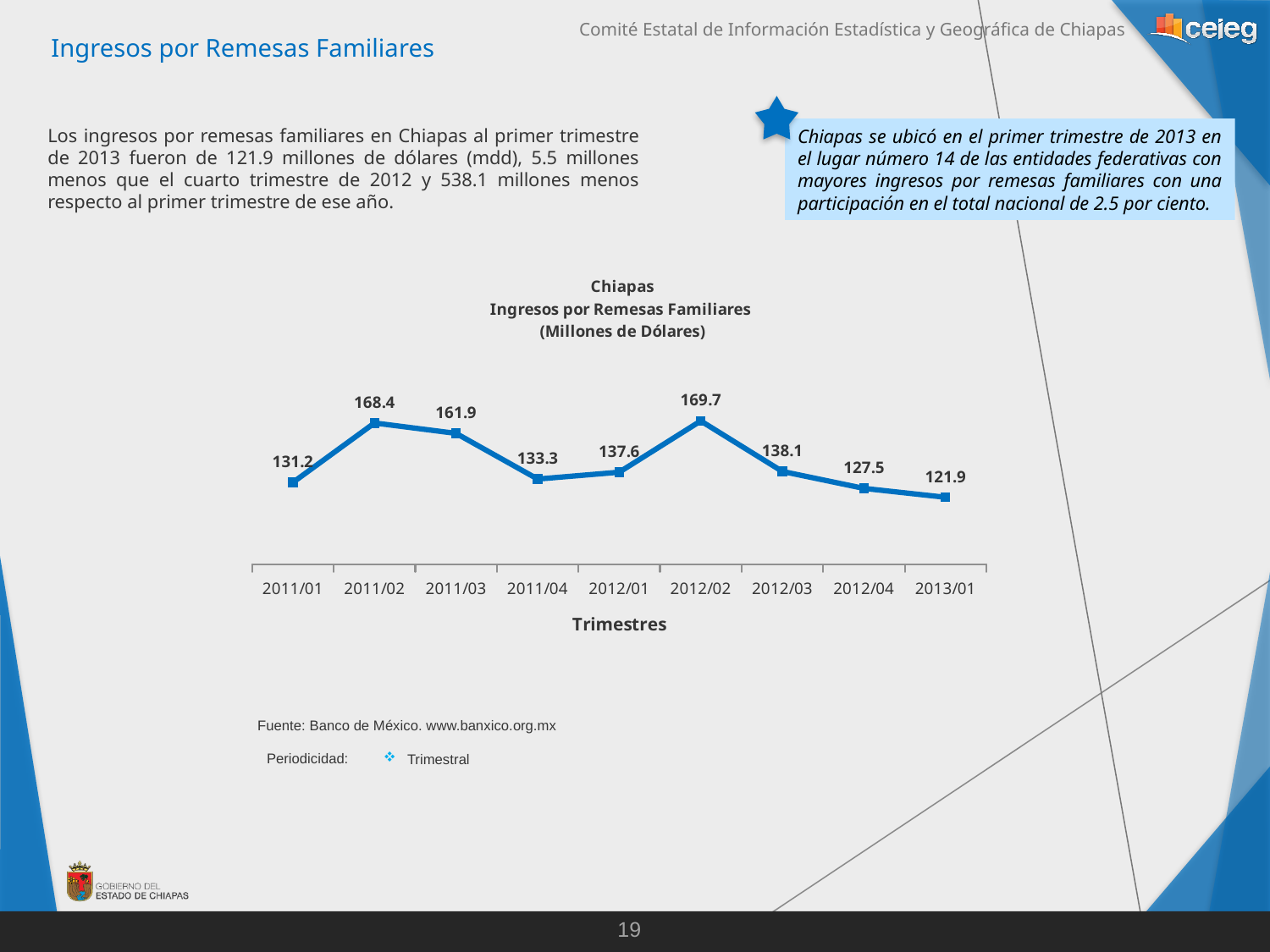
What kind of chart is shown? Line chart Which is larger, the value for 2011/04 or the value for 2012/01? 2012/01 What is the difference between the values for 2012/02 and 2012/03? 31.6 What is the value for 2013/01? 121.9 What is the difference between the values for 2011/02 and 2011/01? 37.2 What is the label of the x axis? Trimestres What is the value for 2012/01? 137.6 What is the value for 2011/02? 168.4 Do the values rise or fall from 2012/02 to 2013/01? Fall Which quarter has the lowest value? 2013/01 How many quarters are plotted on the chart? 9 Which quarter has the highest value? 2012/02